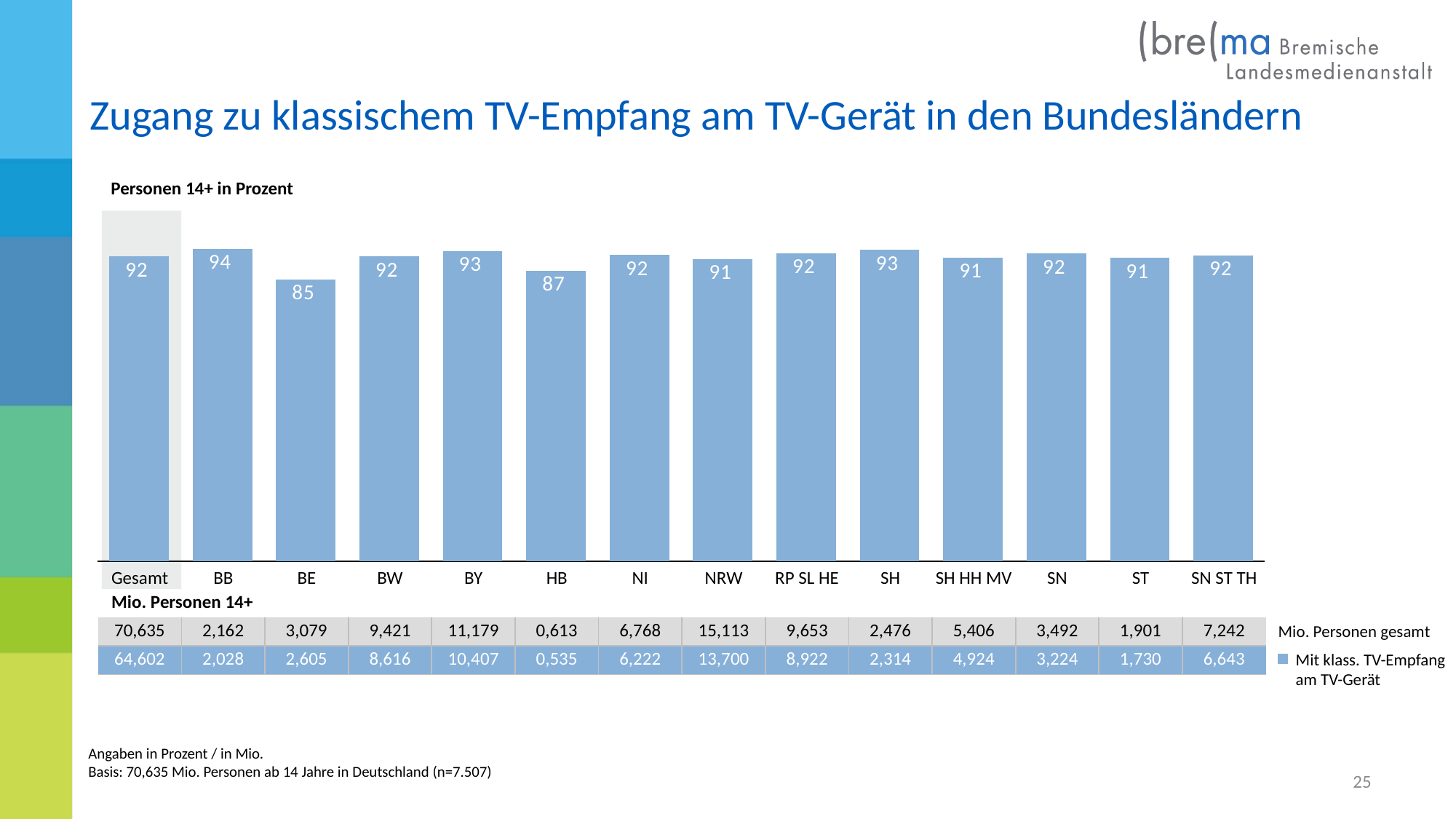
What is the value for HB in the chart? 87 What is the difference between the values for BB and BE? 9 In the table below the chart, what is the 'Mit klass. TV-Empfang am TV-Gerät' value for BY? 10,407 What is the value for Gesamt in the chart? 92 Which category has the highest value in the chart? BB What kind of chart is shown on the slide? Bar chart Which category has the lowest value in the chart? BE Which has a larger value, HB or BY? BY How many categories are shown on the x axis of the chart? 14 In the table below the chart, what is the 'Mio. Personen gesamt' value for NRW? 15,113 What is the label shown above the chart describing the unit of the bars? Personen 14+ in Prozent What is the value for BE in the chart? 85